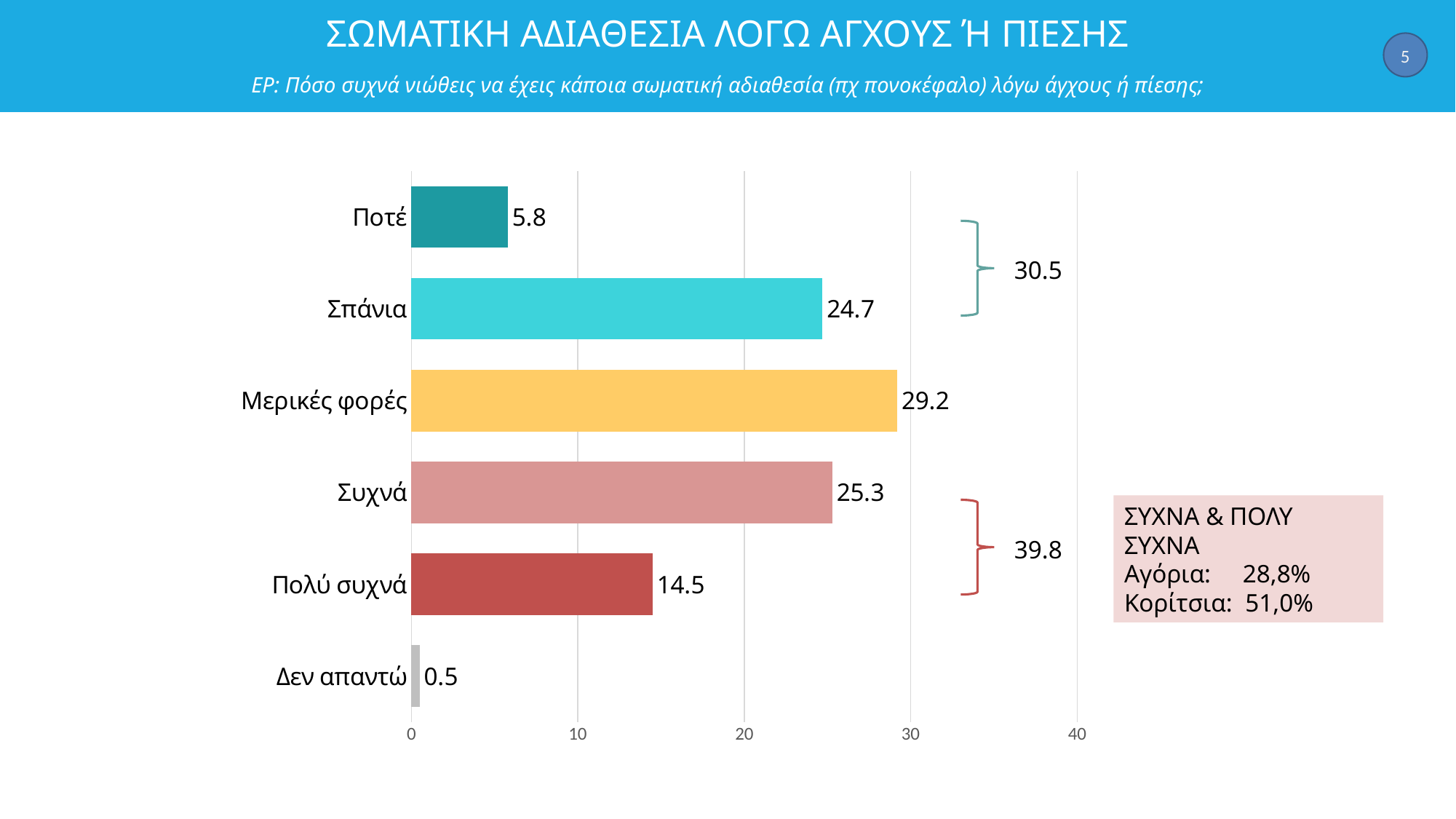
What combined value is shown by the bracket grouping Συχνά and Πολύ συχνά? 39.8 What is the value for Μερικές φορές? 29.2 Which is larger, the value for Σπάνια or the value for Συχνά? Συχνά What is the difference between the values for Συχνά and Πολύ συχνά? 10.8 What kind of chart is shown on the slide? bar chart Which category has the lowest value? Δεν απαντώ What is the value for Δεν απαντώ? 0.5 Is the value for Πολύ συχνά greater or less than 20? less Which category has the highest value? Μερικές φορές What is the highest tick value shown on the horizontal axis? 40 How many categories are shown in the chart? 6 What is the value for Ποτέ? 5.8